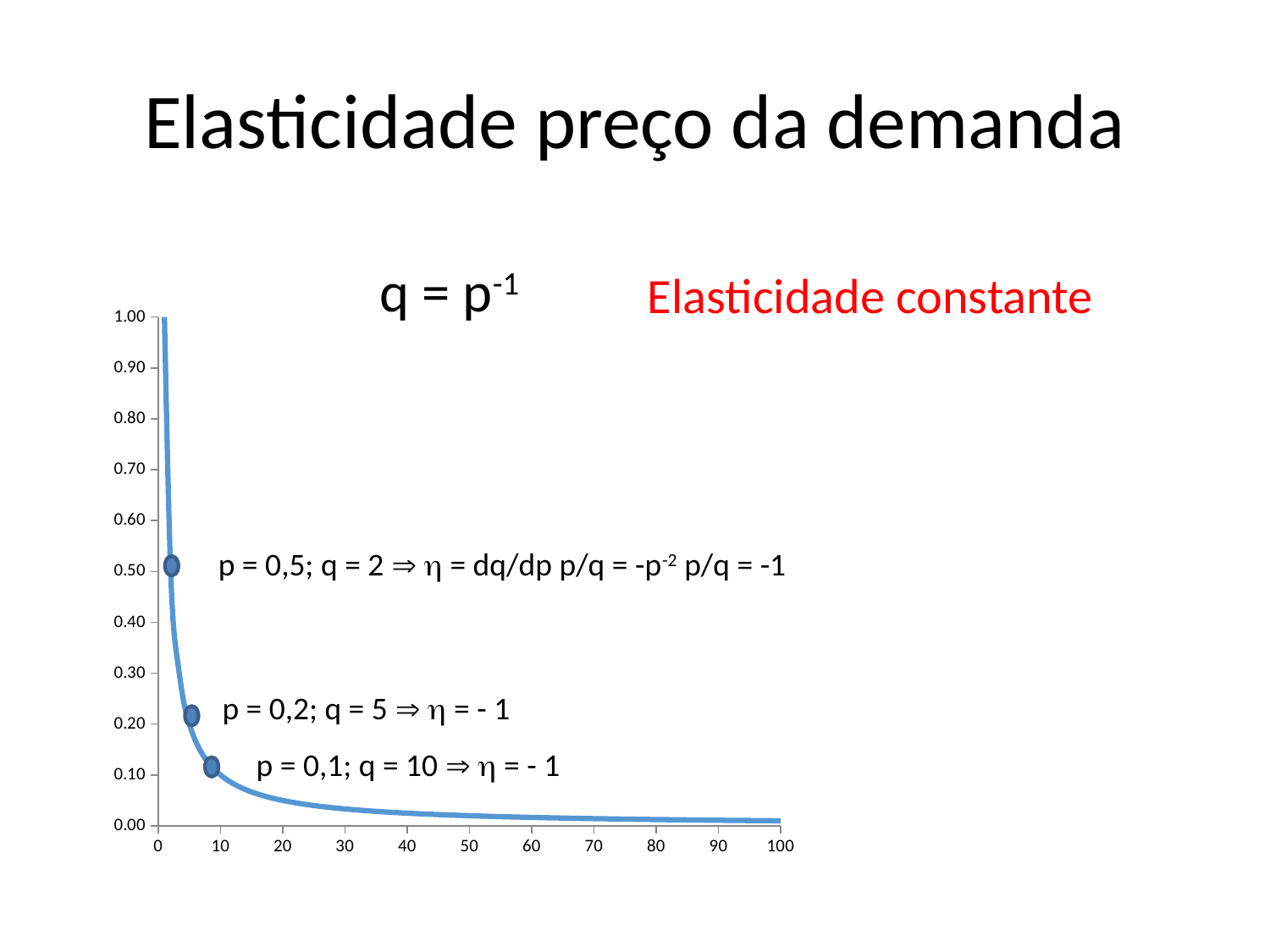
What is the elasticity η given for the point p = 0,2; q = 5? - 1 Is the value of the curve at x = 1 greater or less than 0.90? greater What kind of chart is shown on the slide? line chart Is the value of the curve at x = 50 greater or less than 0.10? less What equation is given as the chart's title? q = p⁻¹ Which of the marked points has the larger p value: the one with q = 2 or the one with q = 10? q = 2 What is the highest value shown on the y axis? 1.00 According to the annotation, what is q when p = 0,1? 10 Do the values on the curve rise or fall as the x axis increases? fall According to the annotation, what is q when p = 0,5? 2 How many highlighted points are marked on the curve? 3 According to the annotation, what is q when p = 0,2? 5